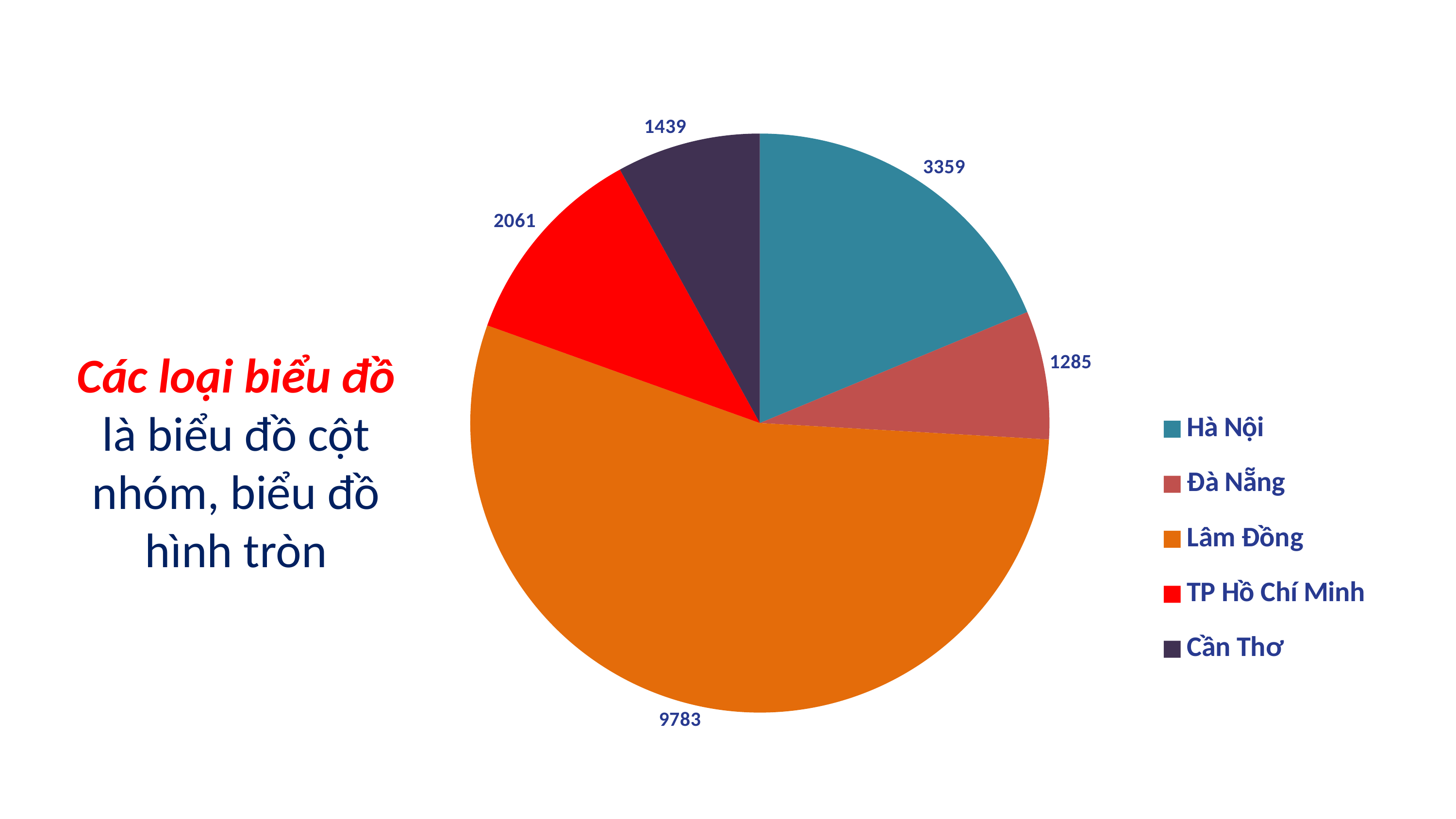
How many slices does the pie chart have? 5 What is the difference between the values for Hà Nội and Đà Nẵng? 2074 What is the value for Hà Nội in the pie chart? 3359 Which category has the smallest slice in the pie chart? Đà Nẵng What is the value for Lâm Đồng in the pie chart? 9783 What colour is the slice for TP Hồ Chí Minh? Red What is the total of all the values shown in the pie chart? 17927 What is the value for TP Hồ Chí Minh in the pie chart? 2061 What kind of chart is shown on the slide? Pie chart What is the value for Cần Thơ in the pie chart? 1439 Which category has the largest slice in the pie chart? Lâm Đồng Which is larger, the value for TP Hồ Chí Minh or the value for Cần Thơ? TP Hồ Chí Minh